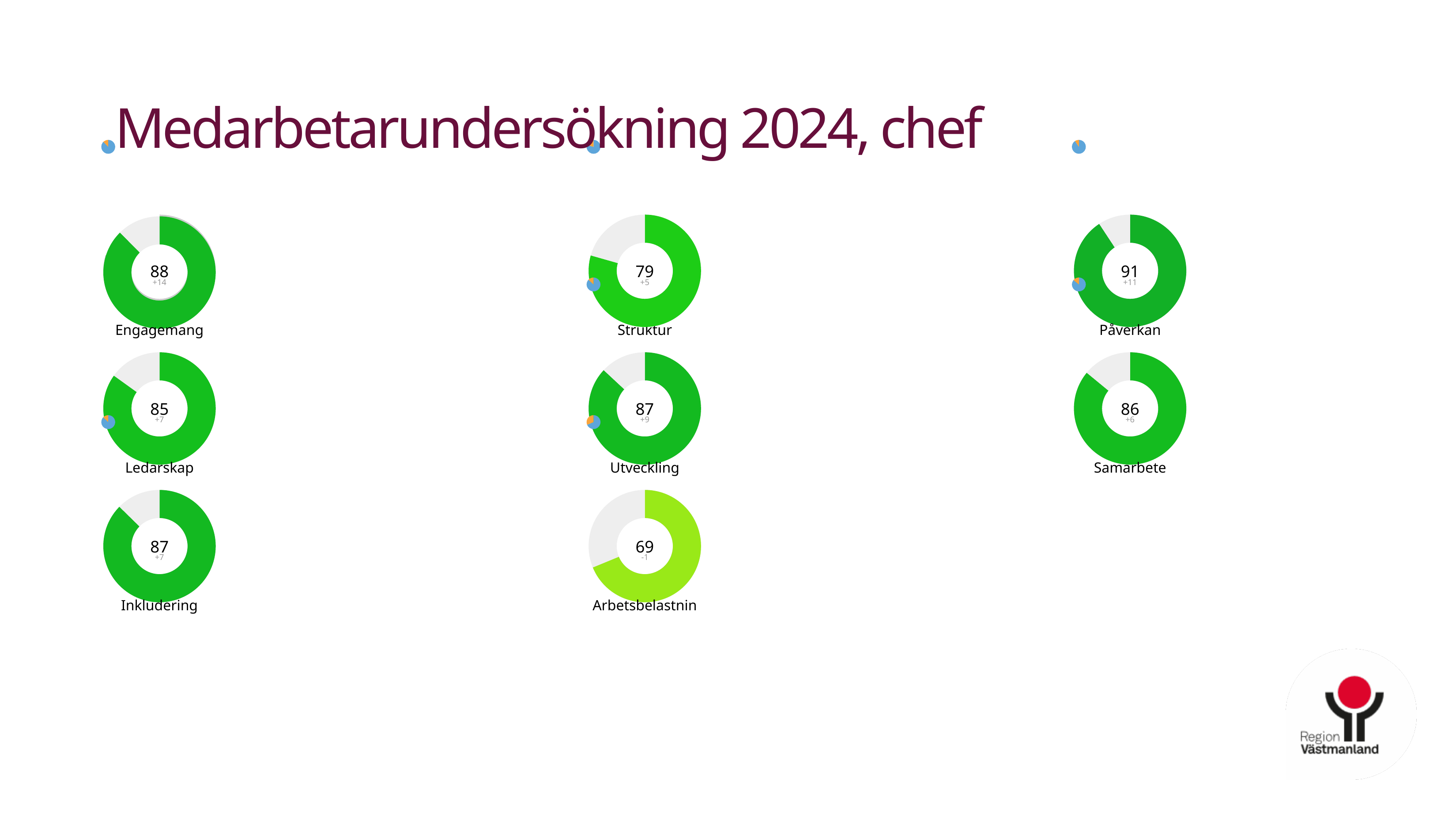
What change figure is printed under the value in the Engagemang donut chart? +14 Which has the larger value, the Ledarskap donut chart or the Samarbete donut chart? Samarbete How many donut charts are shown on the slide? 8 What is the difference between the value in the Påverkan donut chart and the value in the Struktur donut chart? 12 What change figure is printed under the value in the Arbetsbelastnin donut chart? -1 What value is shown in the centre of the Arbetsbelastnin donut chart? 69 Which of the donut charts on the slide shows the lowest value? Arbetsbelastnin Which of the donut charts on the slide shows the highest value? Påverkan What value is shown in the centre of the Struktur donut chart? 79 What value is shown in the centre of the Påverkan donut chart? 91 What value is shown in the centre of the Engagemang donut chart? 88 What kind of chart is used for Utveckling on the slide? Donut chart